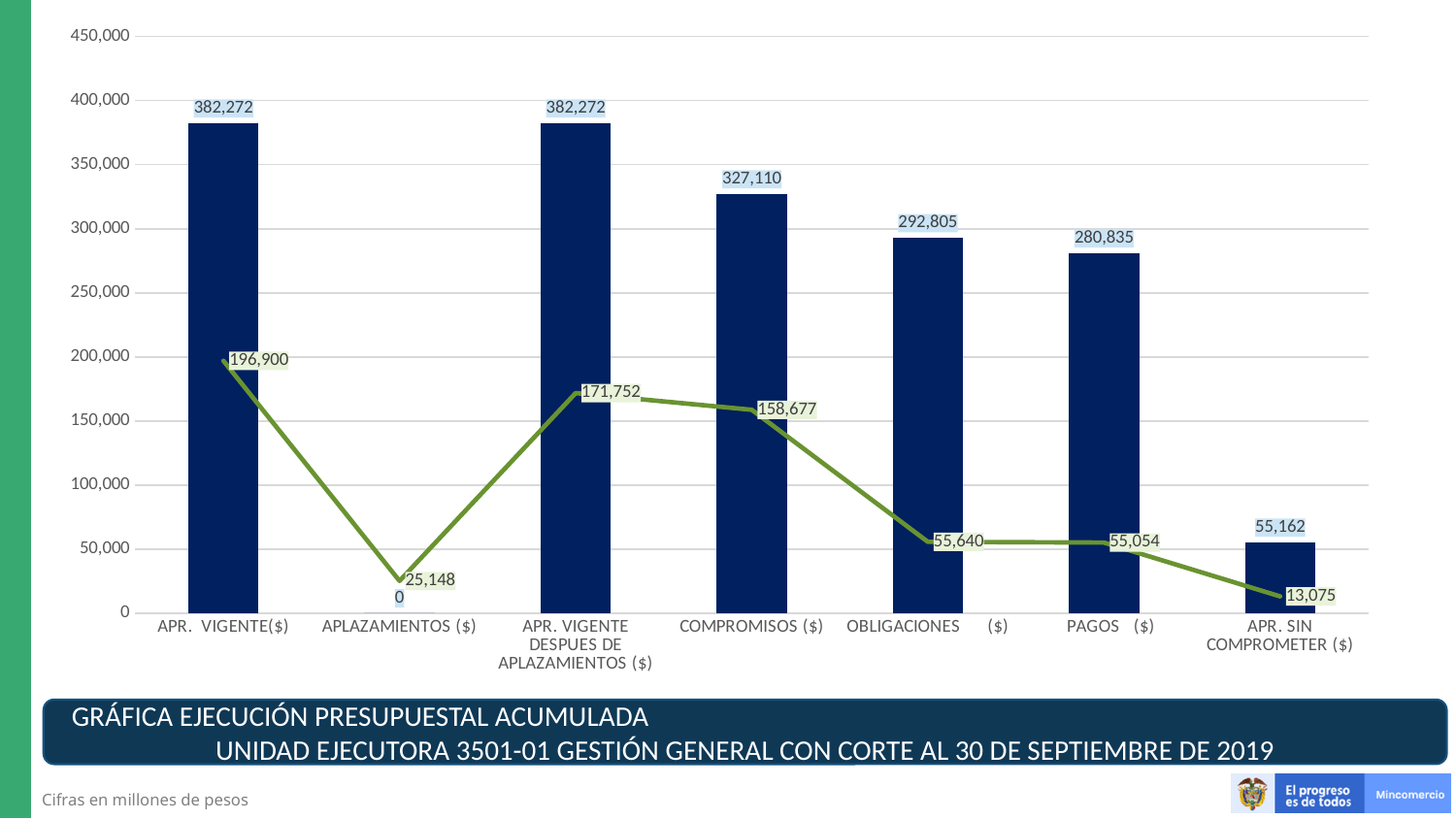
What is the bar value for PAGOS ($)? 280,835 Which is larger, the bar value for OBLIGACIONES ($) or the bar value for PAGOS ($)? OBLIGACIONES ($) What is the value of the green line at OBLIGACIONES ($)? 55,640 What is the value of the green line at APR. VIGENTE($)? 196,900 How many categories are shown on the x axis? 7 Does the green line rise or fall from COMPROMISOS ($) to APR. SIN COMPROMETER ($)? fall What is the difference between the bar value and the line value for APR. SIN COMPROMETER ($)? 42,087 What is the bar value for APLAZAMIENTOS ($)? 0 Which category has the lowest value on the green line? APR. SIN COMPROMETER ($) What is the difference between the bar values for COMPROMISOS ($) and OBLIGACIONES ($)? 34,305 Which category has the lowest bar value? APLAZAMIENTOS ($) What is the bar value for COMPROMISOS ($)? 327,110